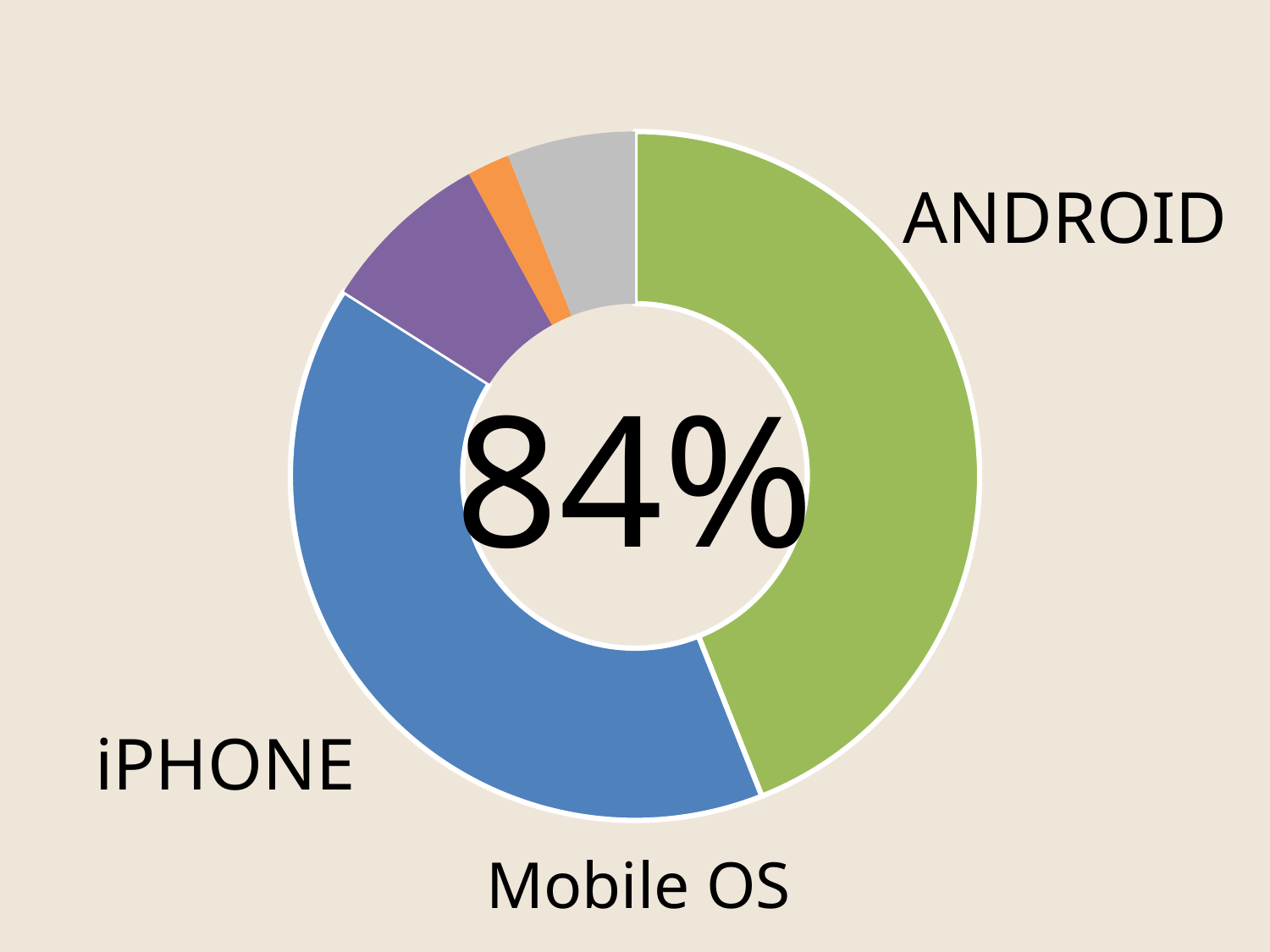
Is the ANDROID slice greater or less than half of the chart? less Which slice is larger, ANDROID or iPHONE? ANDROID How many slices on the chart have a text label next to them? 2 Which of the two labelled categories, ANDROID or iPHONE, has the smaller slice? iPHONE How many slices does the doughnut chart have? 5 What is the title of the chart? Mobile OS Which labelled category has the largest slice of the chart? ANDROID Which category is shown in green on the chart? ANDROID What percentage is printed in the centre of the doughnut chart? 84% What kind of chart is shown on the slide? Doughnut (pie) chart